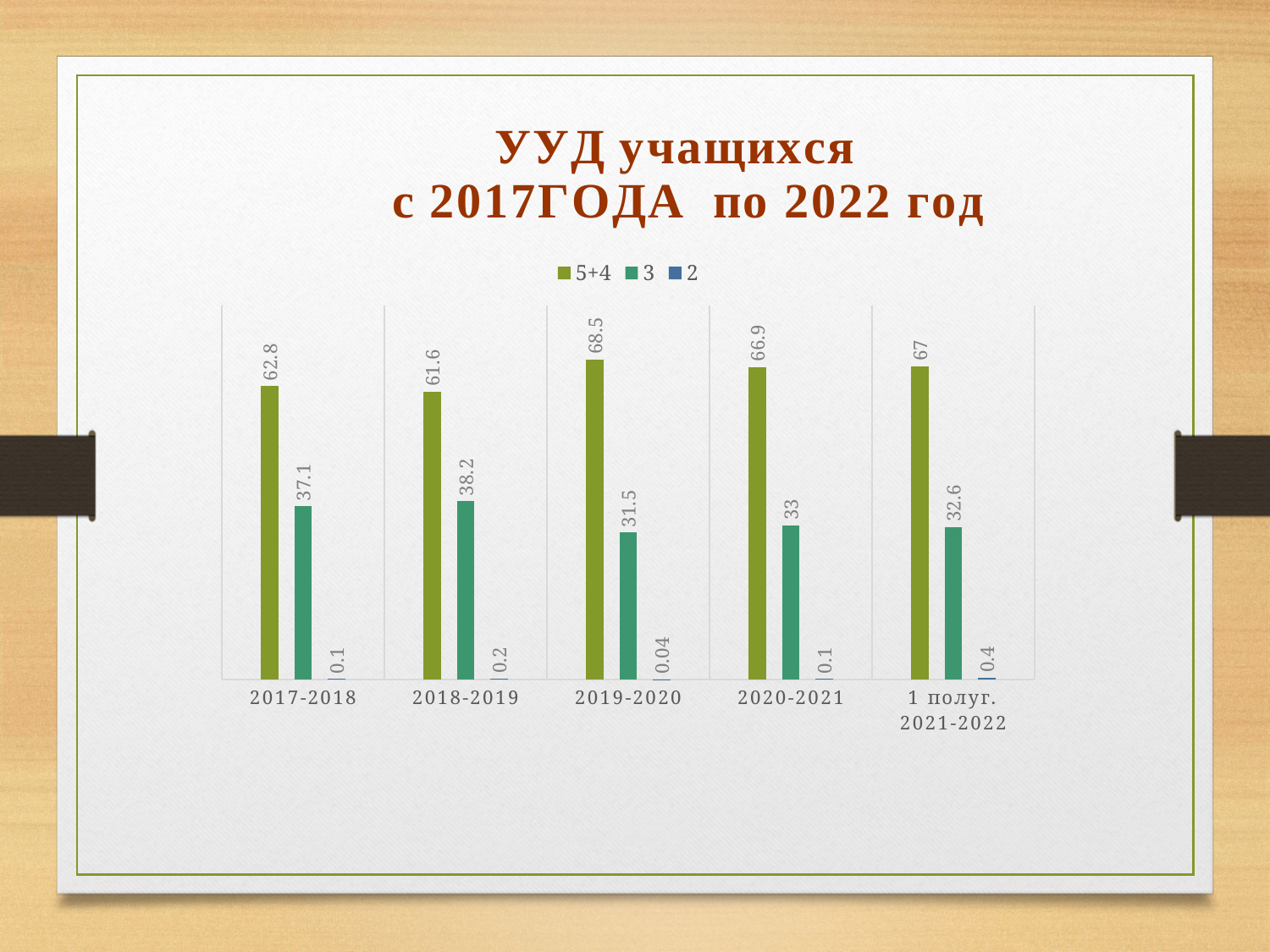
What is the value of the "2" series for 2019-2020? 0.04 What is the value of the "5+4" series for 2017-2018? 62.8 In which period is the "3" series lowest? 2019-2020 What kind of chart is shown on the slide? bar chart In which period is the "5+4" series highest? 2019-2020 How many periods are shown on the x axis? 5 What is the title of the chart? УУД учащихся с 2017ГОДА по 2022 год What is the difference between the "5+4" value for 2019-2020 and for 2017-2018? 5.7 What is the value of the "2" series for 1 полуг. 2021-2022? 0.4 What is the value of the "3" series for 2019-2020? 31.5 How many series does the legend list? 3 Which is larger: the "3" value for 2018-2019 or for 2020-2021? 2018-2019